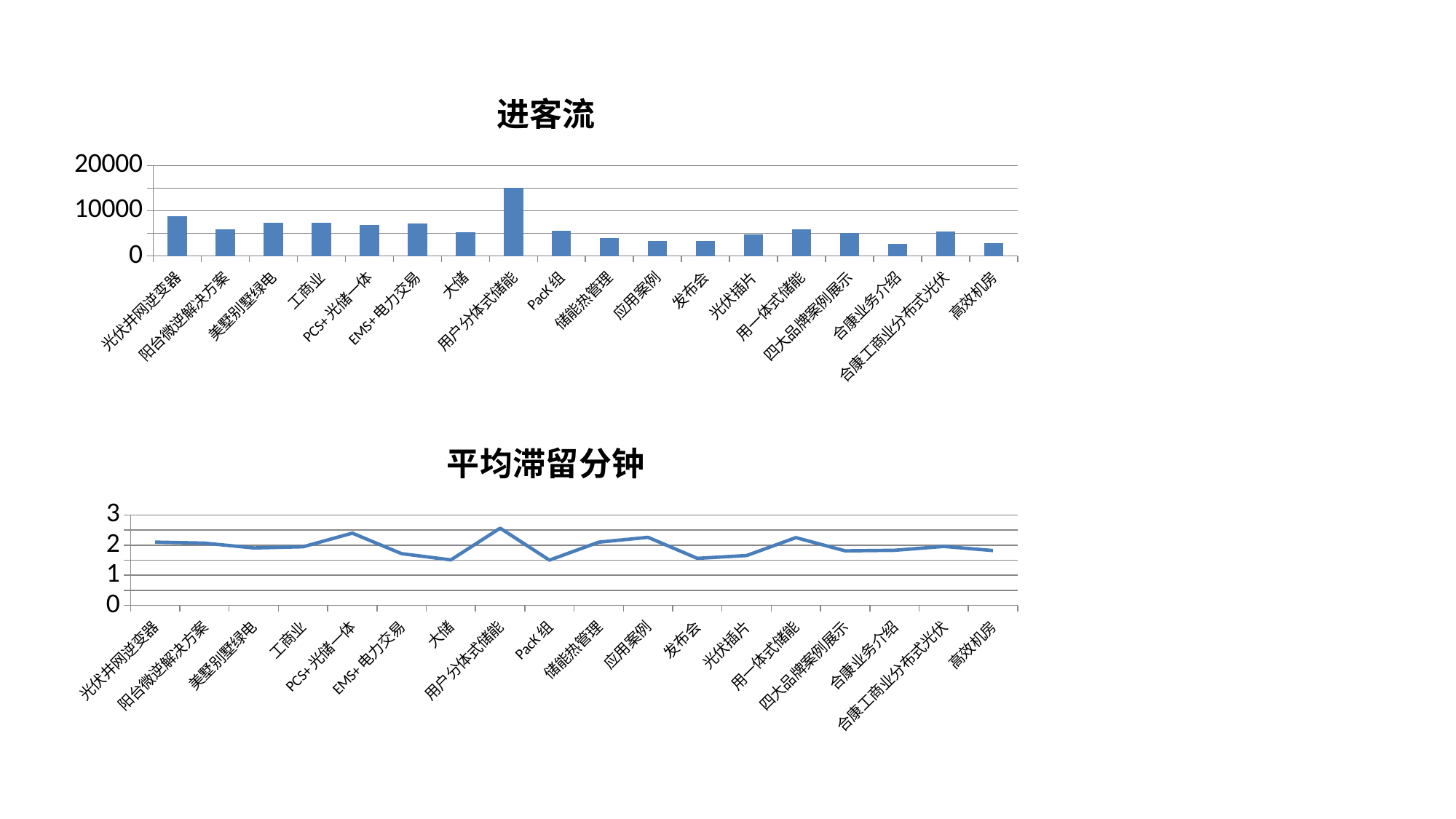
What is the title of the bottom chart? 平均滞留分钟 In the bottom chart 平均滞留分钟, is the value for 用户分体式储能 greater or less than 2? greater In the bottom chart 平均滞留分钟, is the value for 大储 greater or less than 2? less In the top chart 进客流, is the value for 用户分体式储能 greater or less than 10000? greater In the top chart 进客流, which category has the highest value? 用户分体式储能 How many points are plotted on the line in the bottom chart 平均滞留分钟? 18 How many categories are shown on the x axis of the top chart 进客流? 18 What kind of chart is the top chart titled 进客流? bar chart In the top chart 进客流, which is larger, the value for 光伏并网逆变器 or the value for 阳台微逆解决方案? 光伏并网逆变器 What kind of chart is the bottom chart titled 平均滞留分钟? line chart In the bottom chart 平均滞留分钟, which is larger, the value for PCS+光储一体 or the value for EMS+电力交易? PCS+光储一体